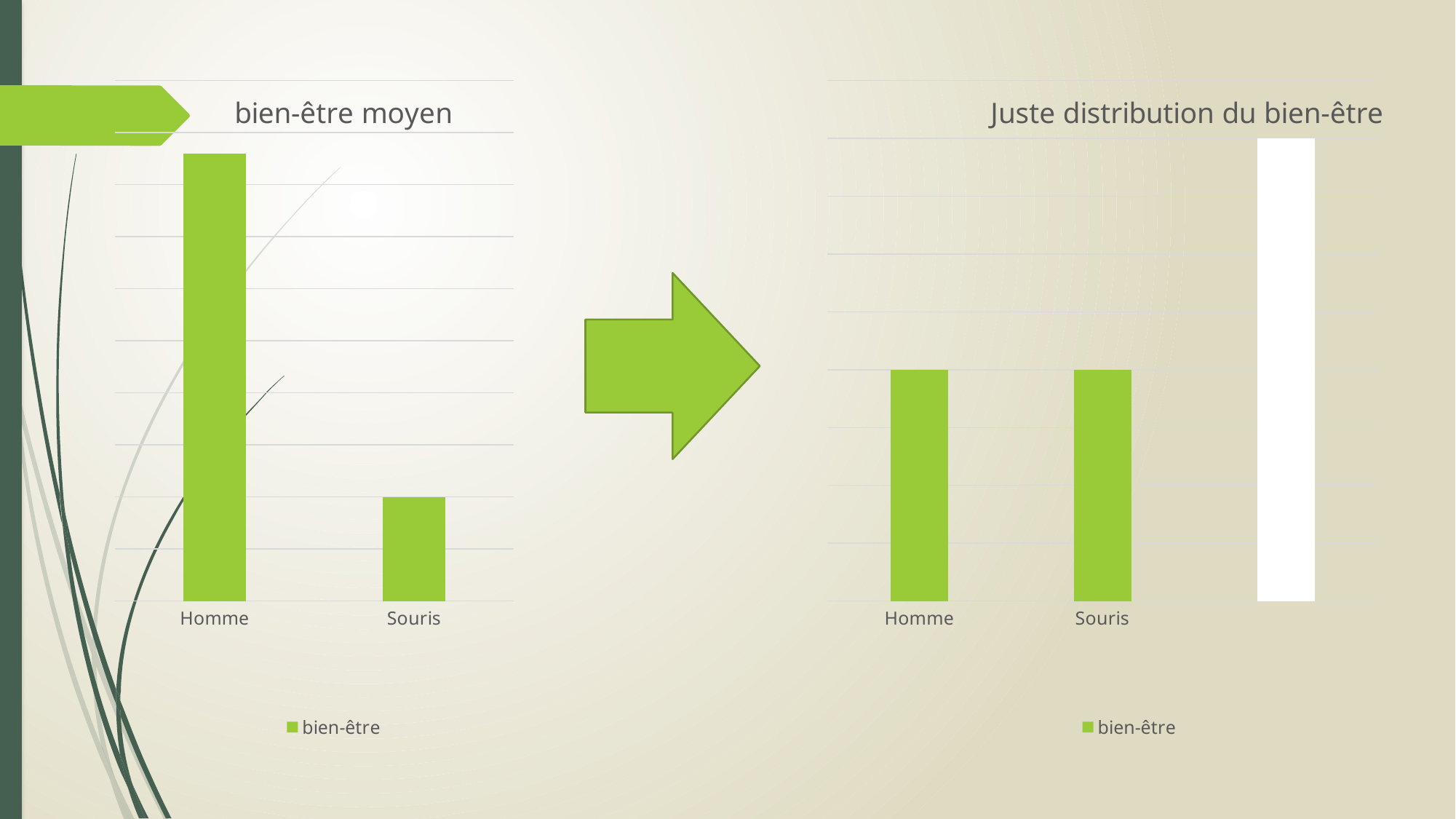
What kind of chart is the chart titled "Juste distribution du bien-être"? Bar chart In the chart titled "bien-être moyen", which category has the lowest value? Souris What series name does the legend show in the chart titled "bien-être moyen"? bien-être What is the title of the chart on the right side of the slide? Juste distribution du bien-être What kind of chart is the chart titled "bien-être moyen"? Bar chart In the chart titled "bien-être moyen", which category has the highest value? Homme In the chart titled "bien-être moyen", which is larger, the value for Homme or the value for Souris? Homme How many series does the legend list in the chart titled "Juste distribution du bien-être"? 1 How many categories are shown in the chart titled "Juste distribution du bien-être"? 3 How many categories are shown in the chart titled "bien-être moyen"? 2 How many series does the legend list in the chart titled "bien-être moyen"? 1